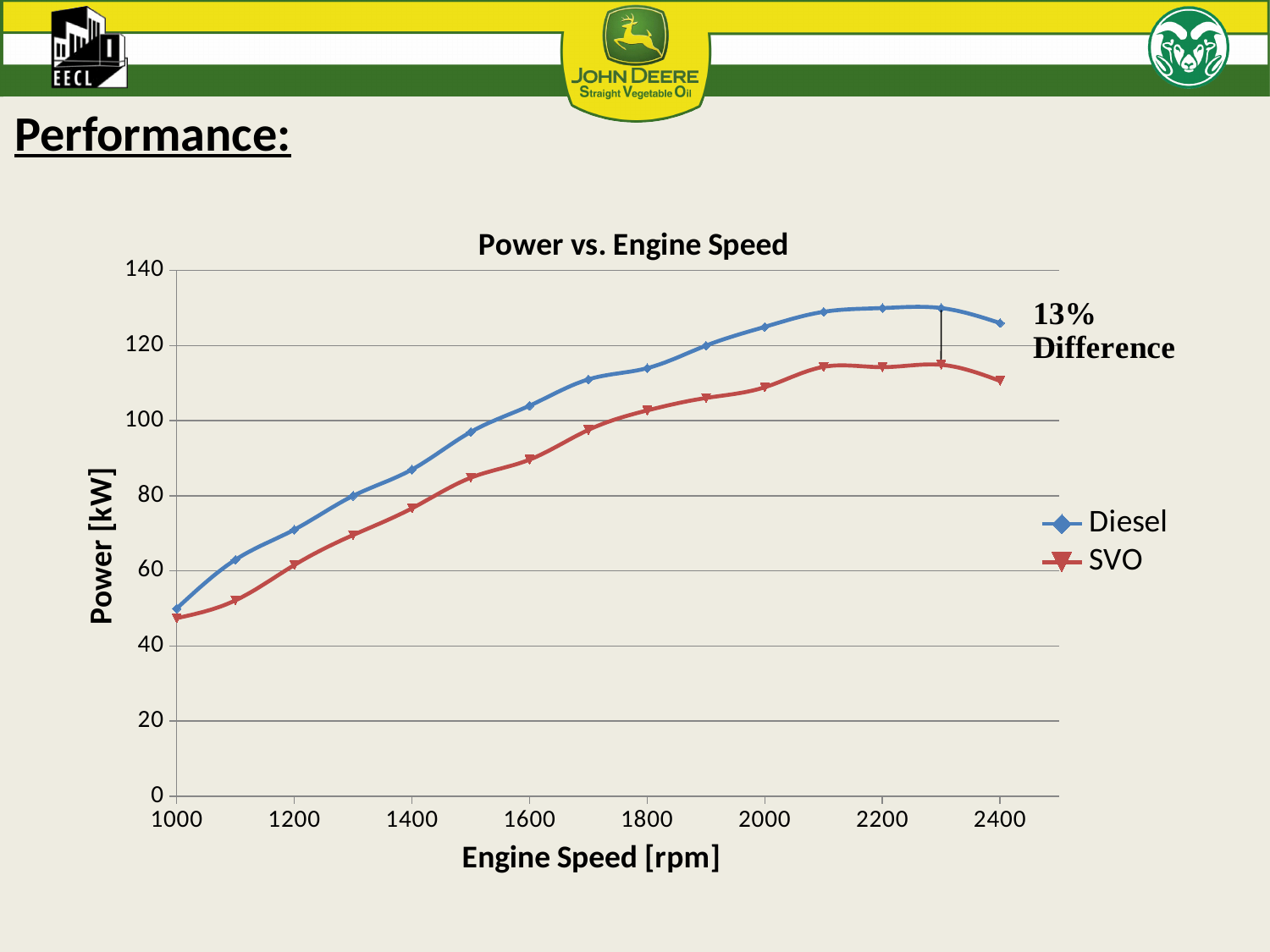
Is the SVO value at 1000 rpm greater or less than 60? less How many series does the legend list? 2 Is the Diesel value at 2200 rpm greater or less than 120? greater What is the title of the chart? Power vs. Engine Speed Which series has the higher power at 1600 rpm, Diesel or SVO? Diesel Does the Diesel power generally rise or fall as engine speed increases from 1000 to 2200 rpm? rise What percentage difference is annotated on the chart? 13% Is the Diesel value at 1400 rpm greater or less than 80? greater What kind of chart is shown on the slide? line chart How many data points are plotted for the Diesel series? 15 At which engine speed is the SVO power lowest? 1000